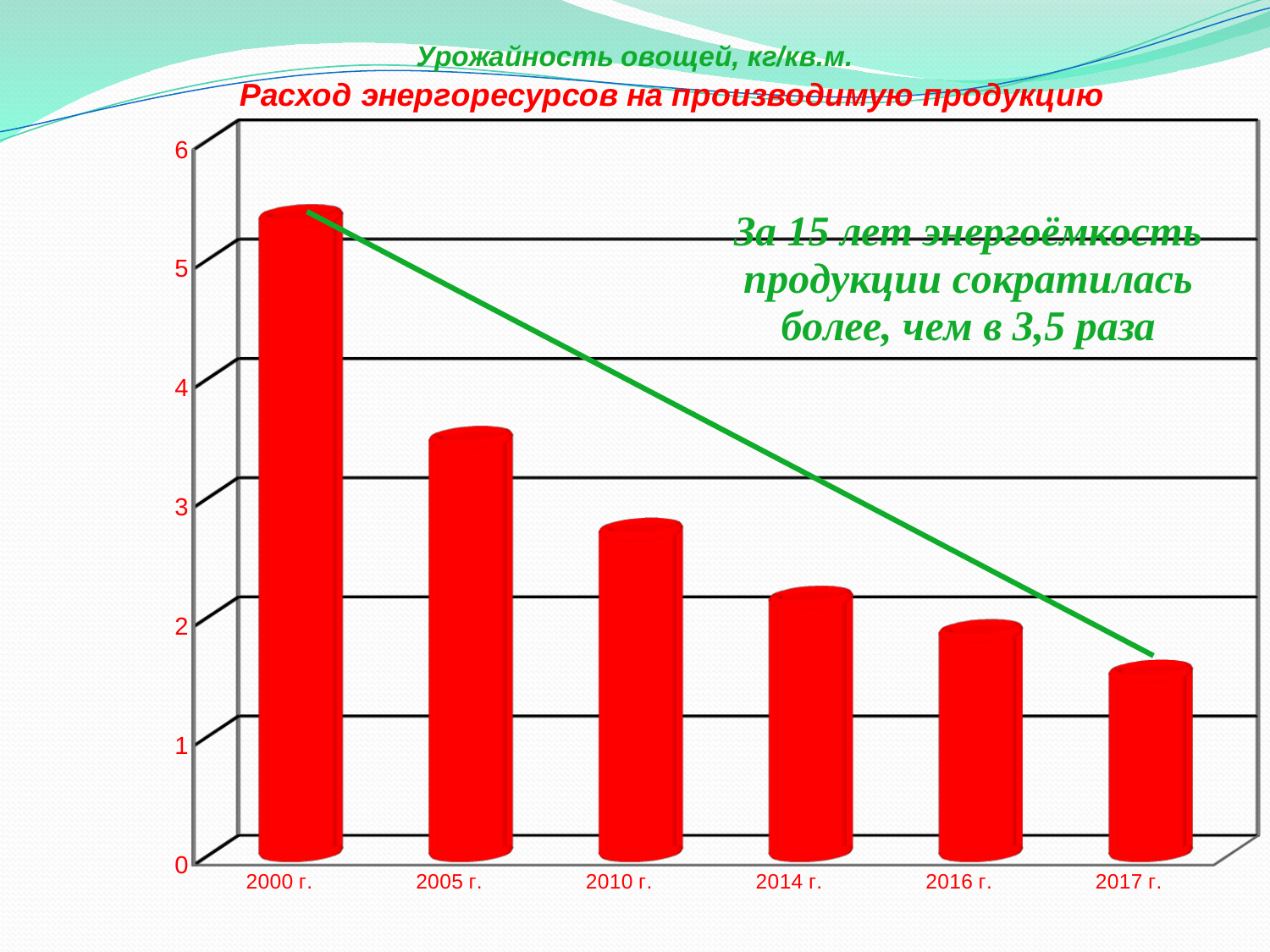
Is the value for 2017 г. greater or less than 2? less What colour are the bars in the chart? red Which year has the lowest value in the chart? 2017 г. Is the value for 2014 г. greater or less than 2? greater What kind of chart is shown on the slide? bar chart Which is larger, the value for 2005 г. or the value for 2010 г.? 2005 г. Do the values rise or fall from 2000 г. to 2017 г.? fall Is the value for 2005 г. greater or less than 3? greater Which year has the highest value in the chart? 2000 г. How many categories (years) are shown on the x axis of the chart? 6